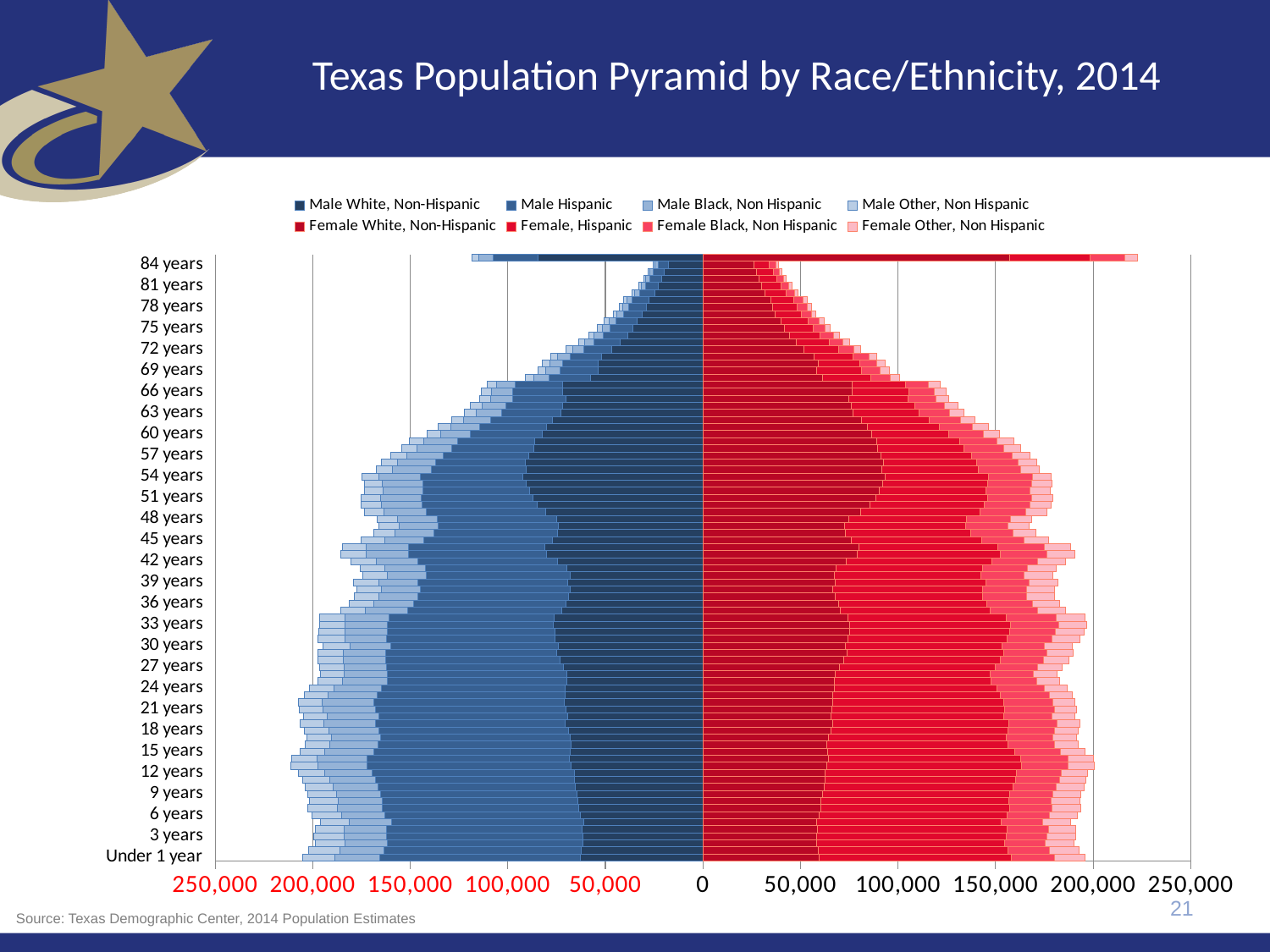
Which colour family is used for the male series and which for the female series? Male in blue, female in red How many age labels are shown on the vertical axis? 29 Is the total male value for 69 years greater or less than 150,000? less Is the total male value for 60 years greater or less than 150,000? less How many series does the legend list? 8 Which is larger, the total male bar for 33 years or the total male bar for 69 years? 33 years What kind of chart is shown on the slide? Bar chart (population pyramid) For the 84 years age group, which is larger, the total male bar or the total female bar? Female What is the title of the chart? Texas Population Pyramid by Race/Ethnicity, 2014